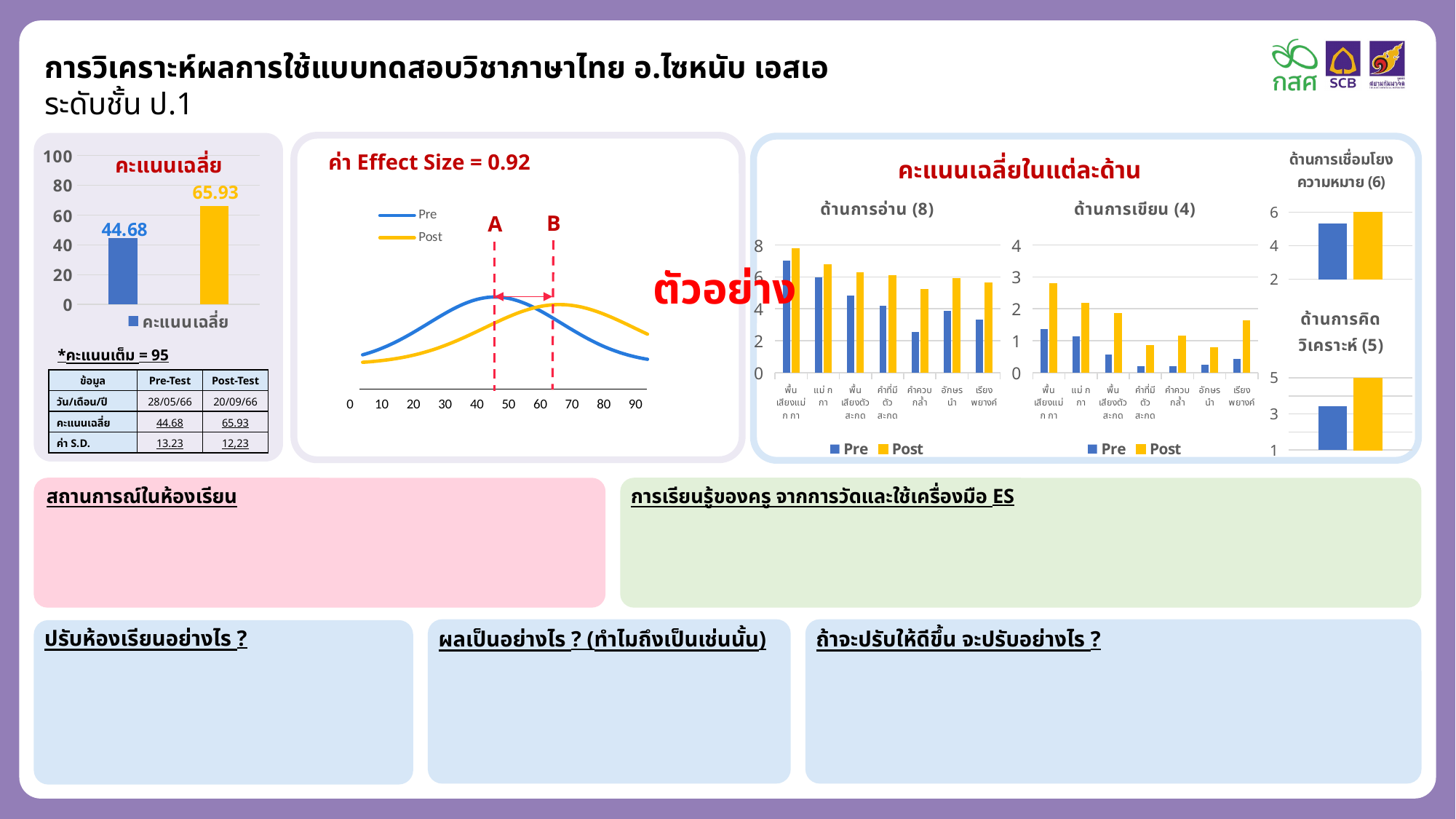
What kind of chart is the คะแนนเฉลี่ย chart? bar chart What Effect Size value is printed on the middle chart? 0.92 In the ด้านการอ่าน (8) chart, which category has the highest Post value? พื้นเสียงแม่กกา In the คะแนนเฉลี่ย chart, what is the difference between the Post value and the Pre value? 21.25 In the คะแนนเฉลี่ย chart, what is the value of the yellow (Post) bar? 65.93 In the ค่า Effect Size chart, how many series does the legend list? 2 In the ด้านการอ่าน (8) chart, is the Post value for พื้นเสียงแม่กกา greater or less than 6? greater In the คะแนนเฉลี่ย chart, what is the value of the blue (Pre) bar? 44.68 In the ด้านการอ่าน (8) chart, how many categories are shown on the x axis? 7 In the ด้านการเขียน (4) chart, is the Pre value for เรียงพยางค์ greater or less than 1? less In the คะแนนเฉลี่ย chart, which bar is larger, the blue one or the yellow one? the yellow one In the ด้านการคิดวิเคราะห์ (5) chart, which bar is larger, Pre or Post? Post